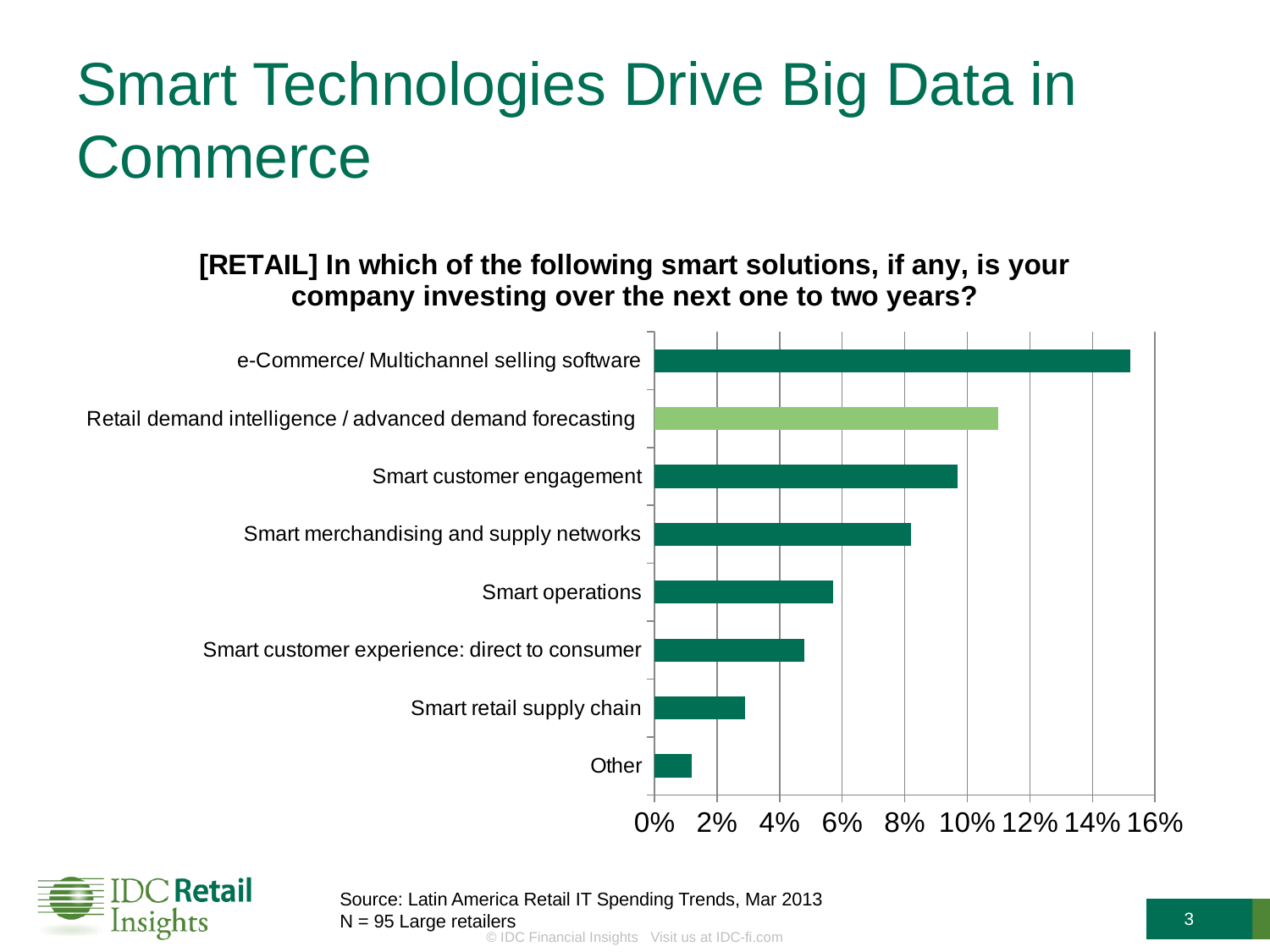
Which category has the lowest value in the chart? Other Is the value for Retail demand intelligence / advanced demand forecasting greater or less than 10%? greater Is the value for Smart retail supply chain greater or less than 4%? less Is the value for Other greater or less than 2%? less Which smart solution has the highest share of companies investing? e-Commerce/ Multichannel selling software Which is larger: the value for Smart customer engagement or the value for Smart merchandising and supply networks? Smart customer engagement Which is larger: the value for Smart operations or the value for Smart customer experience: direct to consumer? Smart operations How many categories (bars) are shown in the chart? 8 Which category's bar is shown in a lighter green colour than the others? Retail demand intelligence / advanced demand forecasting What kind of chart is shown on the slide? Bar chart